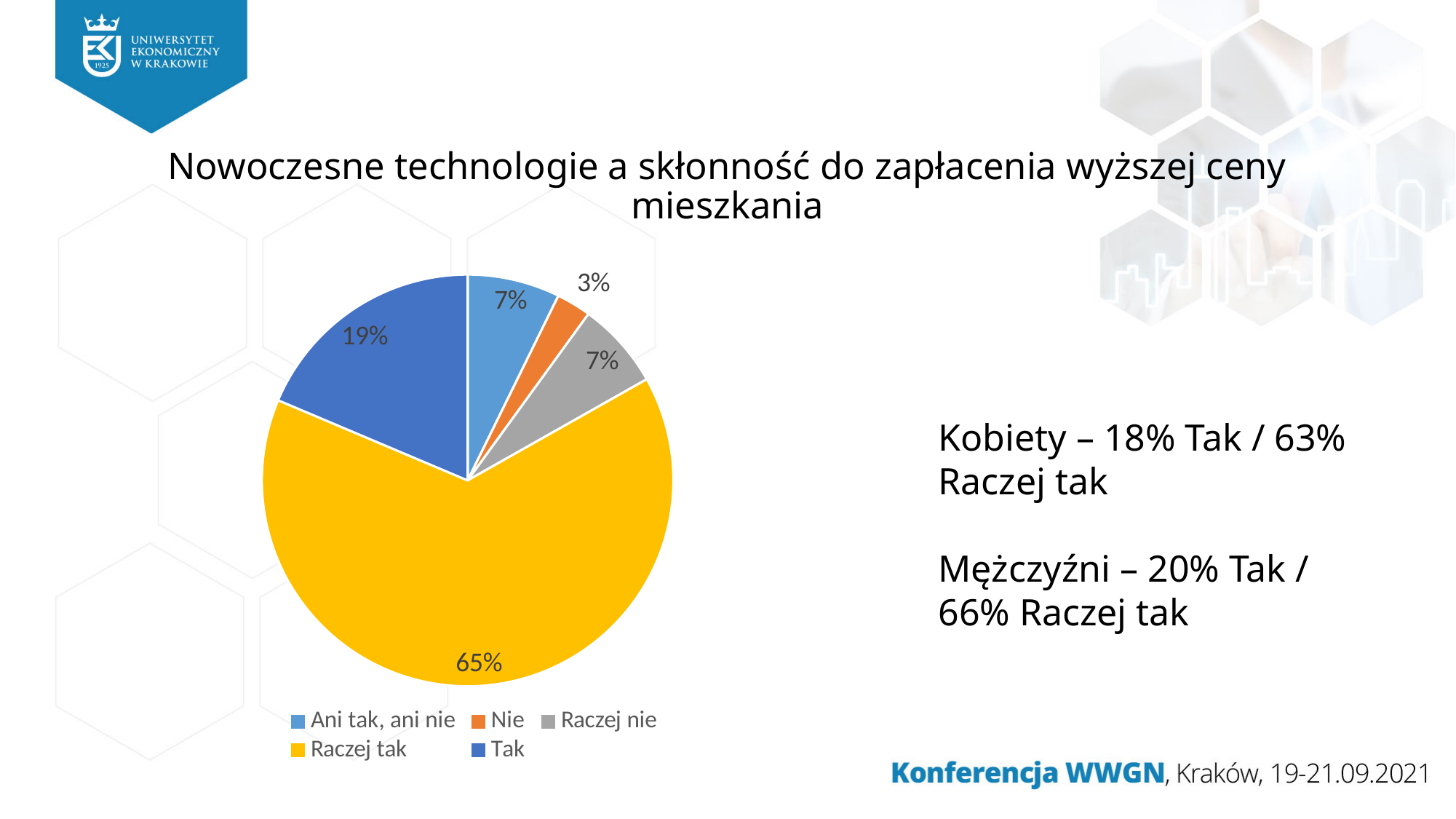
Which category has the largest slice of the pie? Raczej tak How many slices does the pie chart have? 5 Which category has the smallest slice of the pie? Nie What is the difference in percentage points between the "Raczej tak" and "Tak" slices? 46 What share of the pie does the "Raczej tak" slice represent? 65% Which slice is larger, "Tak" or "Raczej nie"? Tak What share of the pie does the "Tak" slice represent? 19% What share of the pie does the "Nie" slice represent? 3% What colour is the "Raczej tak" slice? Yellow What is the combined share of the "Tak" and "Raczej tak" slices? 84% What type of chart is shown on the slide? Pie chart